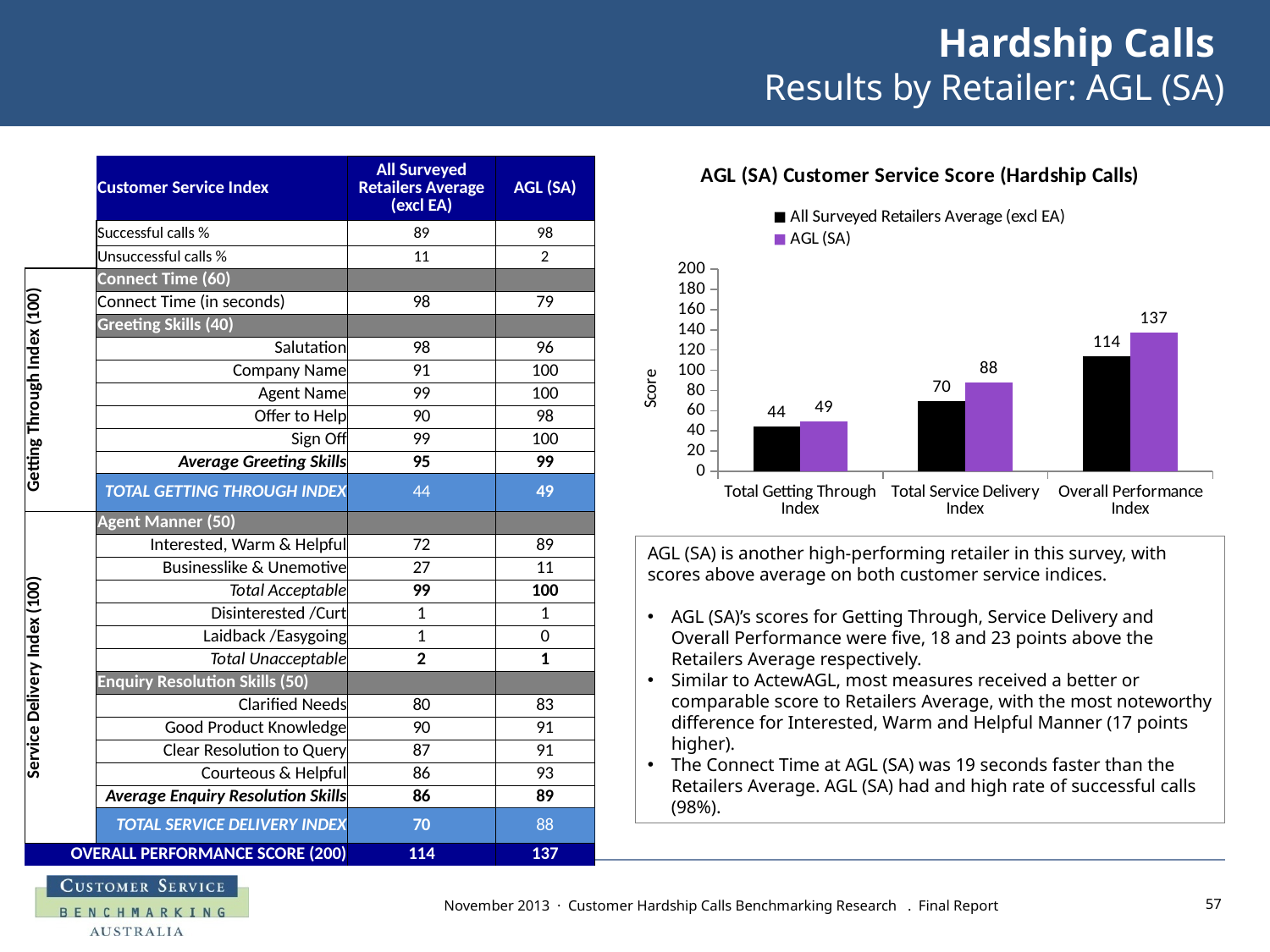
What is the difference between the AGL (SA) and All Surveyed Retailers Average (excl EA) values for Total Service Delivery Index? 18 What is the AGL (SA) value for Overall Performance Index in the chart? 137 For Total Getting Through Index, which is larger: the AGL (SA) value or the All Surveyed Retailers Average (excl EA) value? AGL (SA) Is the All Surveyed Retailers Average (excl EA) value for Overall Performance Index greater or less than 100? greater What type of chart is shown on the slide? Bar chart How many categories are shown on the x axis of the chart? 3 What is the All Surveyed Retailers Average (excl EA) value for Total Getting Through Index in the chart? 44 Which category has the lowest All Surveyed Retailers Average (excl EA) value in the chart? Total Getting Through Index How many series does the chart legend list? 2 What is the difference between the AGL (SA) and All Surveyed Retailers Average (excl EA) values for Overall Performance Index? 23 What is the AGL (SA) value for Total Service Delivery Index in the chart? 88 Which category has the highest AGL (SA) value in the chart? Overall Performance Index